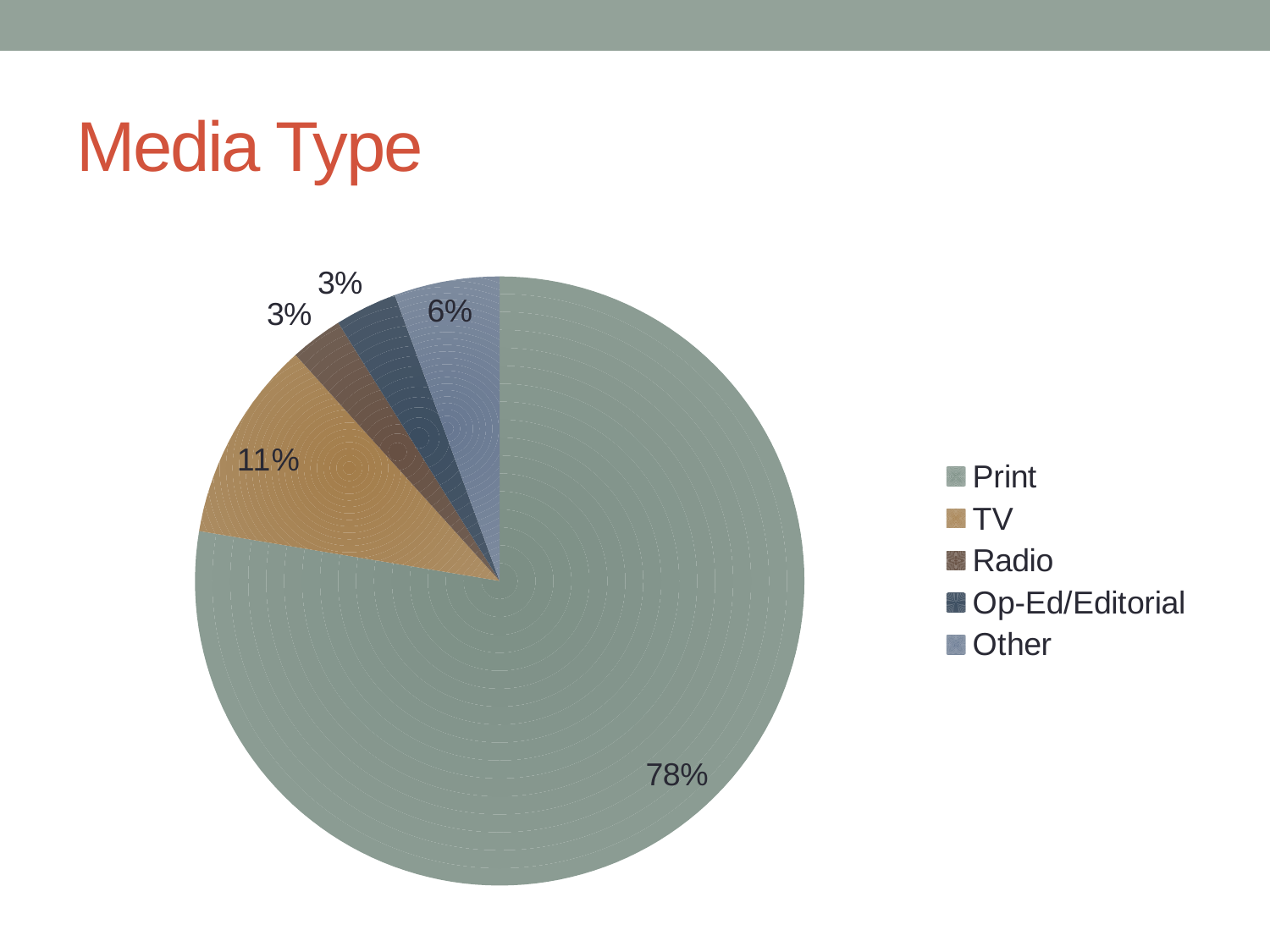
Which category has the largest slice of the pie? Print What share of the pie does Op-Ed/Editorial have? 3% What kind of chart is shown on the slide? pie chart Which is larger, the share for TV or the share for Other? TV What share of the pie does TV have? 11% How many categories does the legend list? 5 What share of the pie does Radio have? 3% What is the title of the slide containing the chart? Media Type What is the difference between the Print share and the TV share? 67% What is the combined share of Radio and Op-Ed/Editorial? 6%